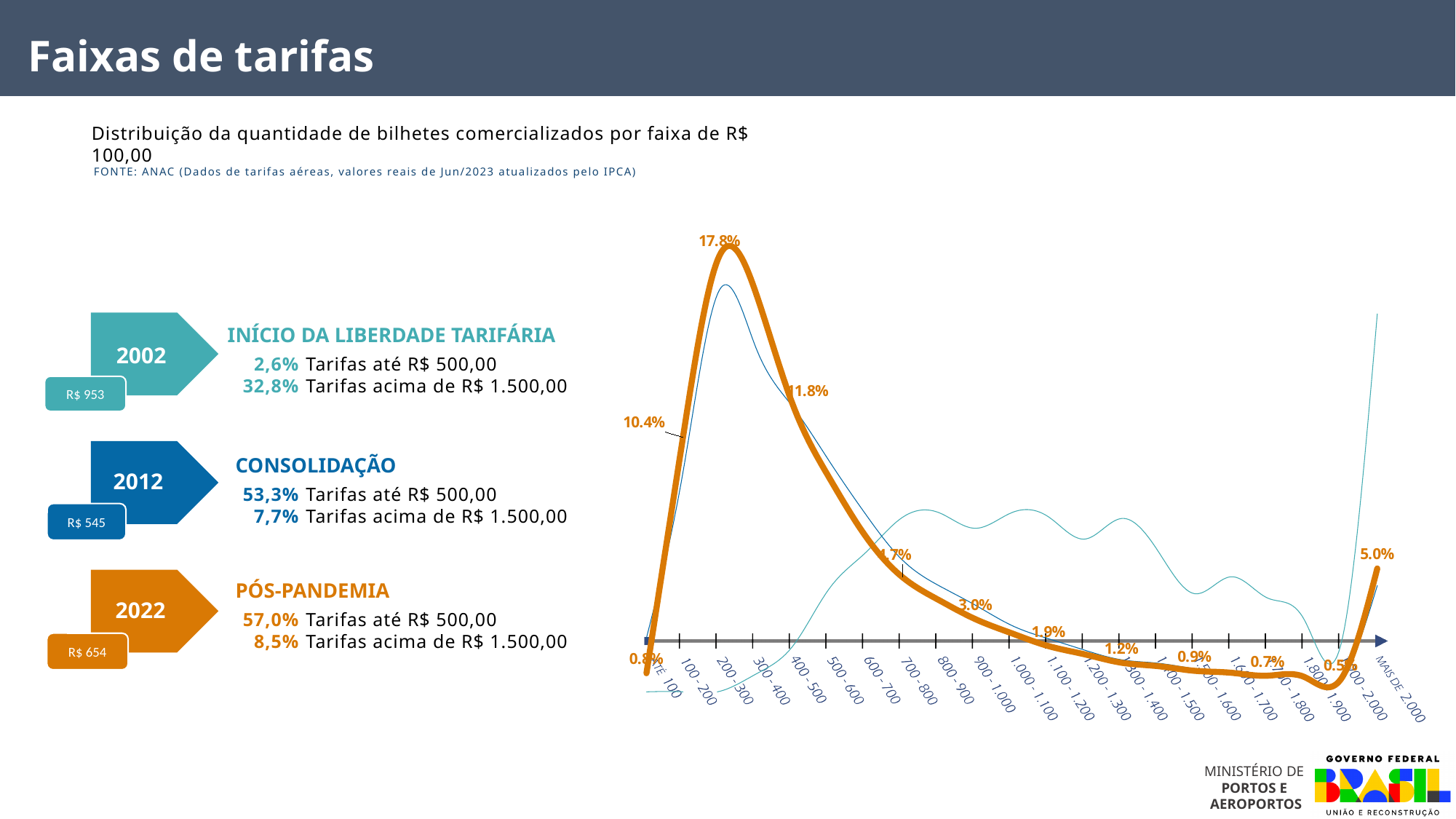
What is the lowest labelled value on the orange line? 0.5% How many fare-range categories are shown on the x axis of the chart? 21 What is the labelled value on the orange line for the '100 - 200' fare range? 10.4% What is the labelled value on the orange line for the 'Até 100' fare range? 0.8% What is the highest labelled value on the thick orange line, and for which fare range? 17.8%, 200 - 300 What is the labelled value on the orange line for the 'Mais de 2.000' fare range? 5.0% How many lines (series) are plotted on the chart? 3 What is the difference between the orange line's labelled values for '200 - 300' and '100 - 200'? 7.4 percentage points On the orange line, which is larger: the value for 'Mais de 2.000' or the value for '1.900 - 2.000'? Mais de 2.000 Which year does the thick orange line on the chart represent? 2022 What kind of chart is shown on the slide? line chart Along the x axis from '200 - 300' to '1.900 - 2.000', do the values on the orange line rise or fall? fall